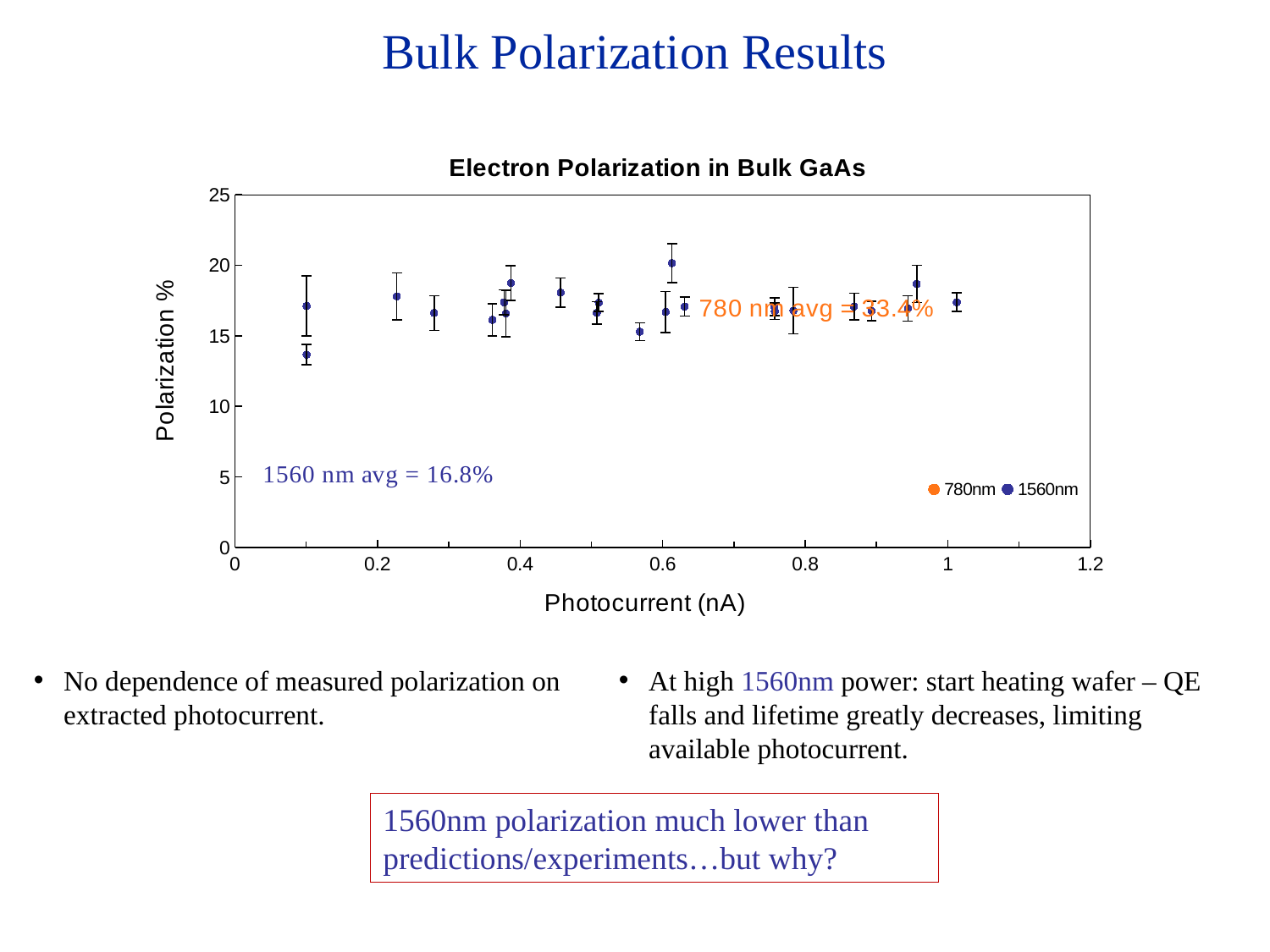
What is the title of the chart? Electron Polarization in Bulk GaAs What kind of chart is shown on the slide? Scatter chart What is the label of the y axis of the chart? Polarization % How many series does the chart legend list? 2 What is the label of the x axis of the chart? Photocurrent (nA) Do the plotted polarization values show a clear rising or falling trend as photocurrent increases along the x axis? No clear trend; roughly flat What is the difference between the 780 nm average polarization and the 1560 nm average polarization shown in the chart annotations? 16.6% What are the two series named in the chart legend? 780nm and 1560nm Are the plotted 1560nm polarization values greater or less than 25 on the y axis? less Which wavelength has the higher average polarization according to the chart annotations, 780 nm or 1560 nm? 780 nm According to the annotation on the chart, what is the average polarization for 1560 nm? 16.8% According to the annotation on the chart, what is the average polarization for 780 nm? 33.4%